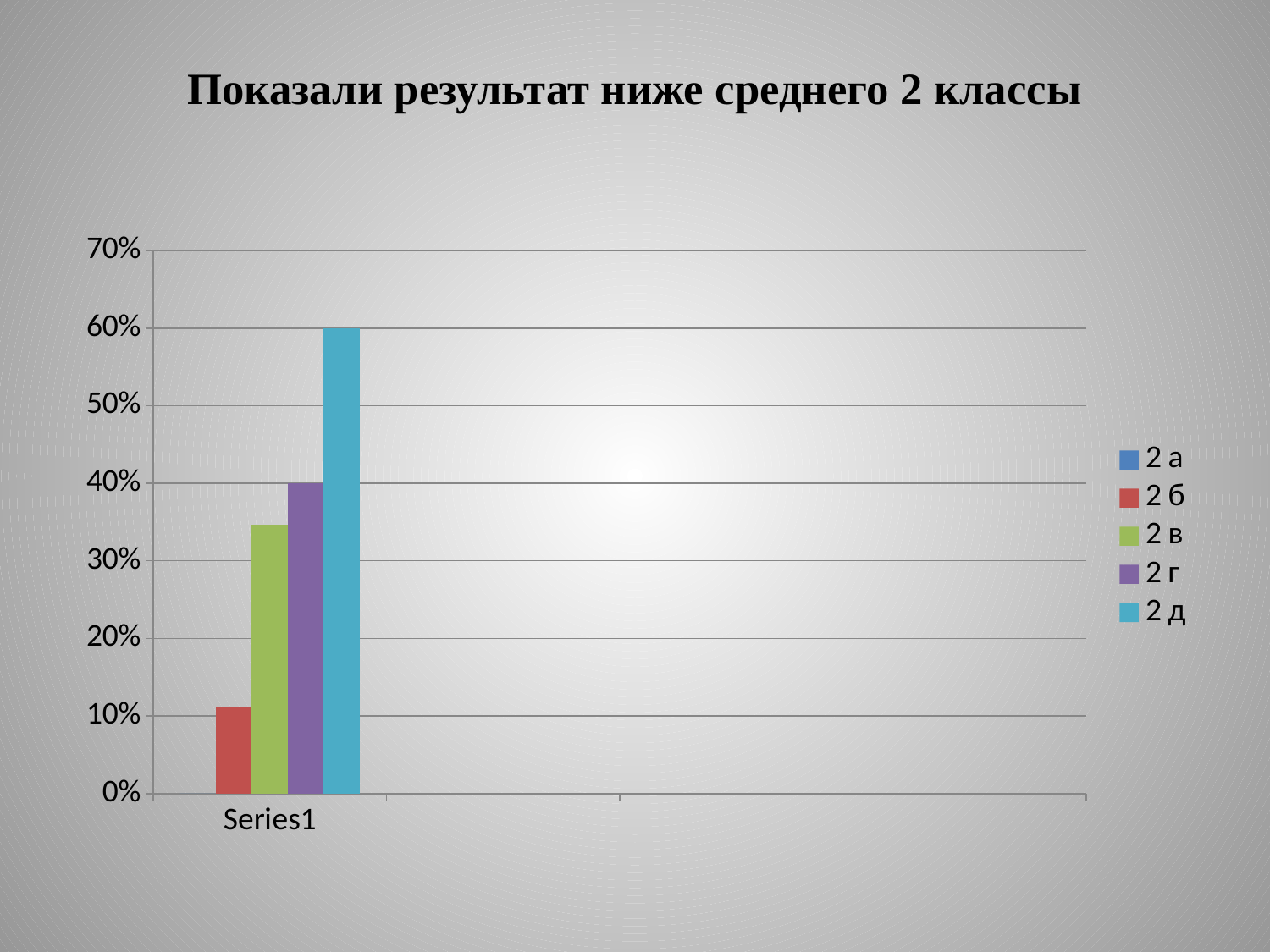
Is the value for 2 б greater or less than 20%? less Is the value for 2 в greater or less than 40%? less What is the title of the chart? Показали результат ниже среднего 2 классы What is the label of the category on the x axis? Series1 What is the difference between the values for 2 д and 2 г? 20% How many series does the legend list? 5 Which series has the tallest bar? 2 д What is the value for 2 д? 60% What is the value for 2 г? 40% Is the value for 2 в greater or less than 30%? greater Which is larger, the value for 2 в or the value for 2 г? 2 г What kind of chart is shown on the slide? bar chart